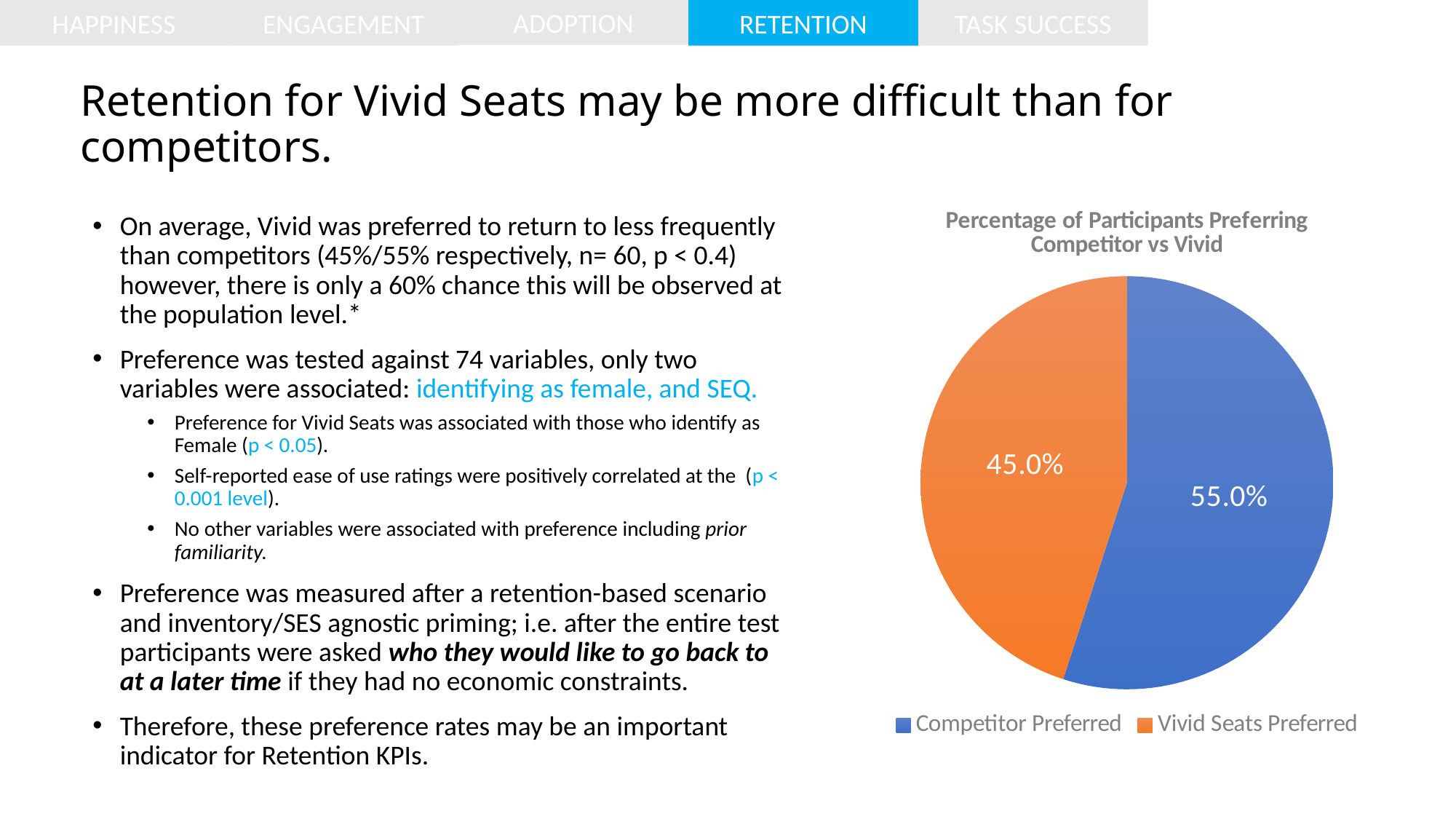
What percentage of participants preferred Vivid Seats? 45.0% How many slices does the pie chart have? 2 What is the difference in percentage points between Competitor Preferred and Vivid Seats Preferred? 10.0% Which category has the larger share of the pie? Competitor Preferred What percentage of participants preferred the competitor? 55.0% Is the share for Vivid Seats Preferred greater or less than 50%? less What colour is the Vivid Seats Preferred slice? Orange Which category has the smaller share of the pie? Vivid Seats Preferred What kind of chart is shown on the slide? Pie chart What is the title of the chart? Percentage of Participants Preferring Competitor vs Vivid Is the share for Competitor Preferred larger or smaller than the share for Vivid Seats Preferred? Larger How many entries does the legend list? 2